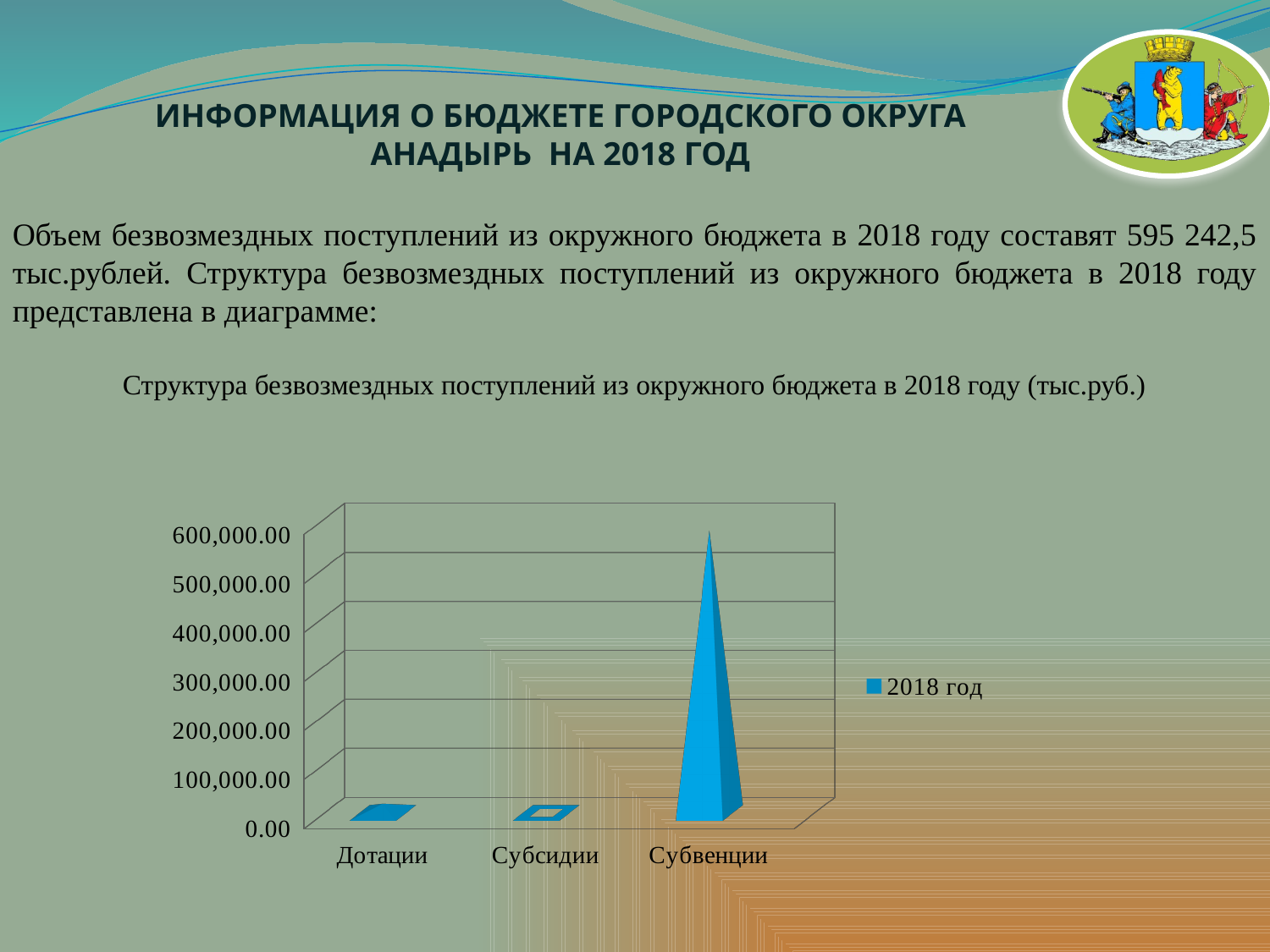
What is the title of the chart? Структура безвозмездных поступлений из окружного бюджета в 2018 году (тыс.руб.) What is the highest tick value shown on the vertical axis of the chart? 600,000.00 Is the value for Субвенции greater or less than 500,000.00? greater What kind of chart is shown on the slide? bar chart Which is larger, the value for Субвенции or the value for Дотации? Субвенции How many categories are shown on the x axis of the chart? 3 Which category has the highest value in the chart? Субвенции Is the value for Дотации greater or less than 100,000.00? less Which is larger, the value for Субсидии or the value for Субвенции? Субвенции What series name is shown in the chart legend? 2018 год How many series does the chart legend list? 1 Is the value for Субсидии greater or less than 100,000.00? less